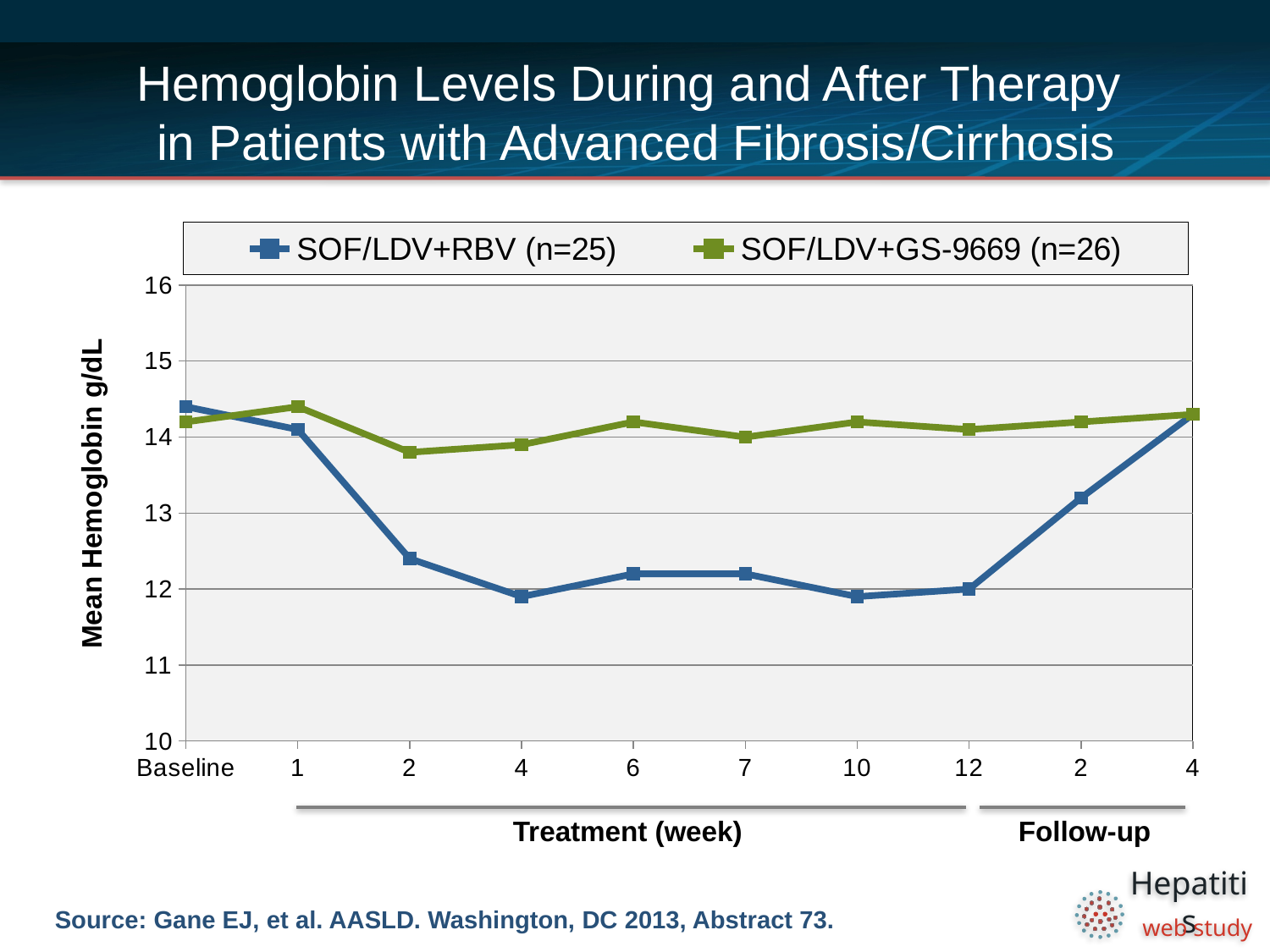
What kind of chart is shown on the slide? line chart How many series does the legend list? 2 Is the value for SOF/LDV+RBV at treatment week 2 greater or less than 13? less Does the SOF/LDV+RBV series rise or fall from baseline to treatment week 4? fall What is the label of the y axis? Mean Hemoglobin g/dL Is the value for SOF/LDV+RBV at follow-up week 2 greater or less than 13? greater At treatment week 4, which series has the higher hemoglobin value? SOF/LDV+GS-9669 (n=26) How many time points are plotted along the x axis? 10 Which series is drawn in green? SOF/LDV+GS-9669 (n=26) Is the value for SOF/LDV+RBV at treatment week 10 greater or less than 13? less Does the SOF/LDV+RBV series rise or fall from treatment week 12 to follow-up week 4? rise